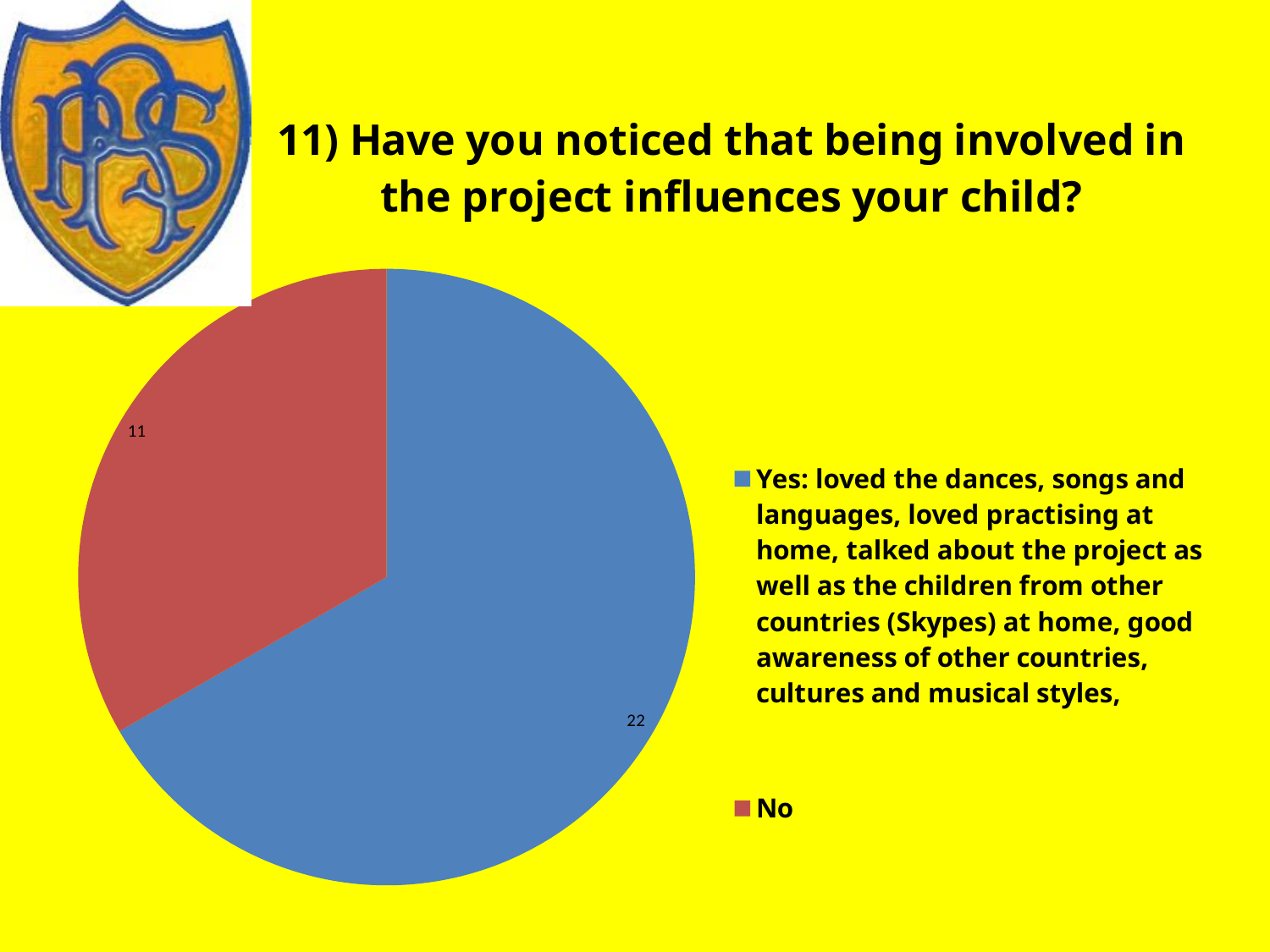
What is the value shown for the "No" slice? 11 Which is larger, the "Yes" slice or the "No" slice? Yes What is the difference between the "Yes" and "No" values? 11 How many slices does the pie chart have? 2 What is the total of the two slices? 33 What colour is the "No" slice? Red What kind of chart is shown on the slide? Pie chart How many entries does the legend list? 2 Which slice is the largest? Yes Which slice is the smallest? No What colour is the "Yes" slice? Blue What is the value shown for the "Yes" slice? 22